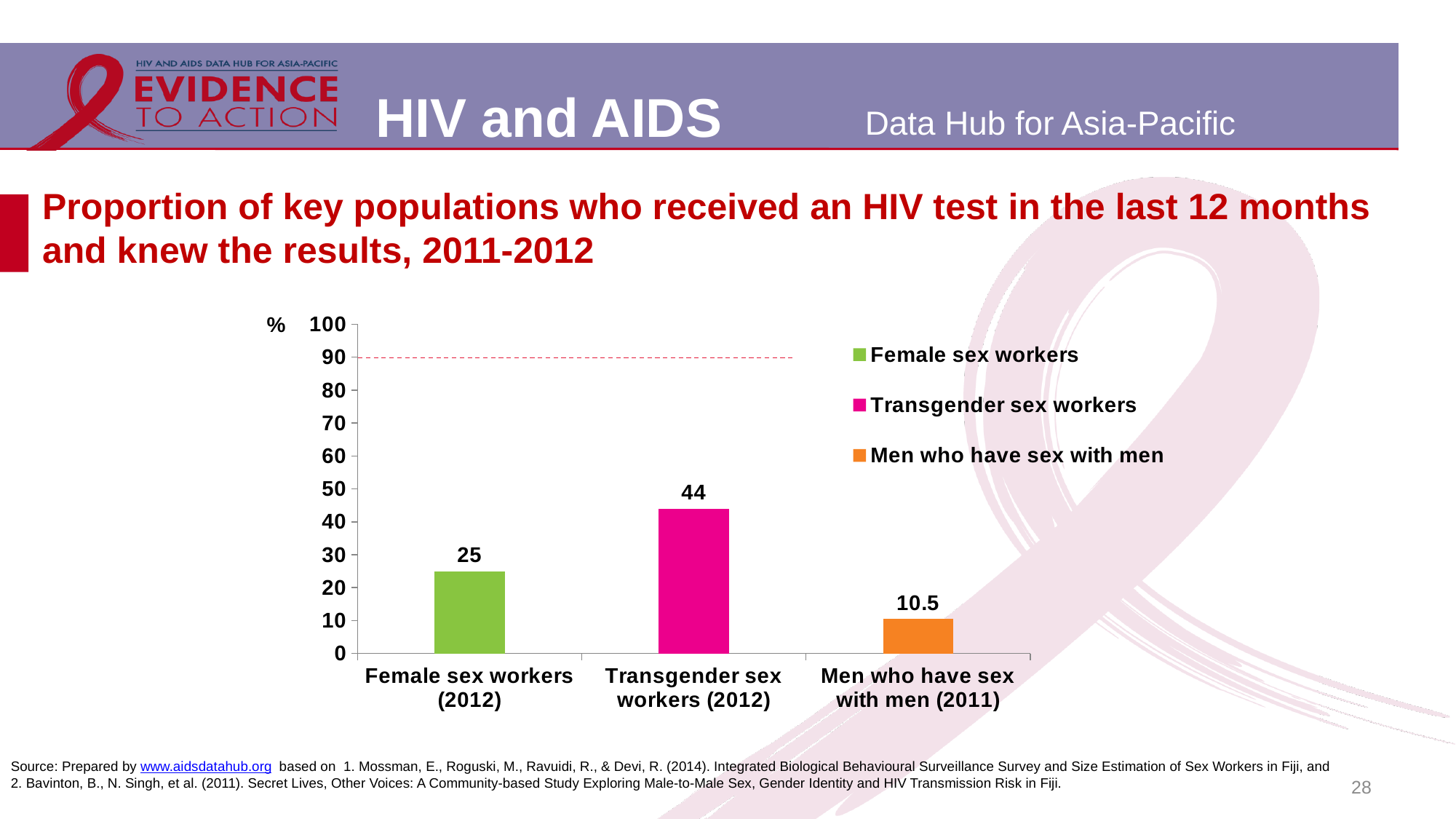
What is the value for Transgender sex workers (2012)? 44 What is the difference between the values for Female sex workers (2012) and Men who have sex with men (2011)? 14.5 Which category has the highest value? Transgender sex workers (2012) How many series does the legend list? 3 What is the value for Men who have sex with men (2011)? 10.5 What is the value for Female sex workers (2012)? 25 What is the difference between the values for Transgender sex workers (2012) and Female sex workers (2012)? 19 What kind of chart is shown on the slide? bar chart Is the value for Transgender sex workers (2012) greater or less than 50? less Which is larger, the value for Female sex workers (2012) or the value for Men who have sex with men (2011)? Female sex workers (2012) How many categories are shown on the x axis? 3 Which category has the lowest value? Men who have sex with men (2011)